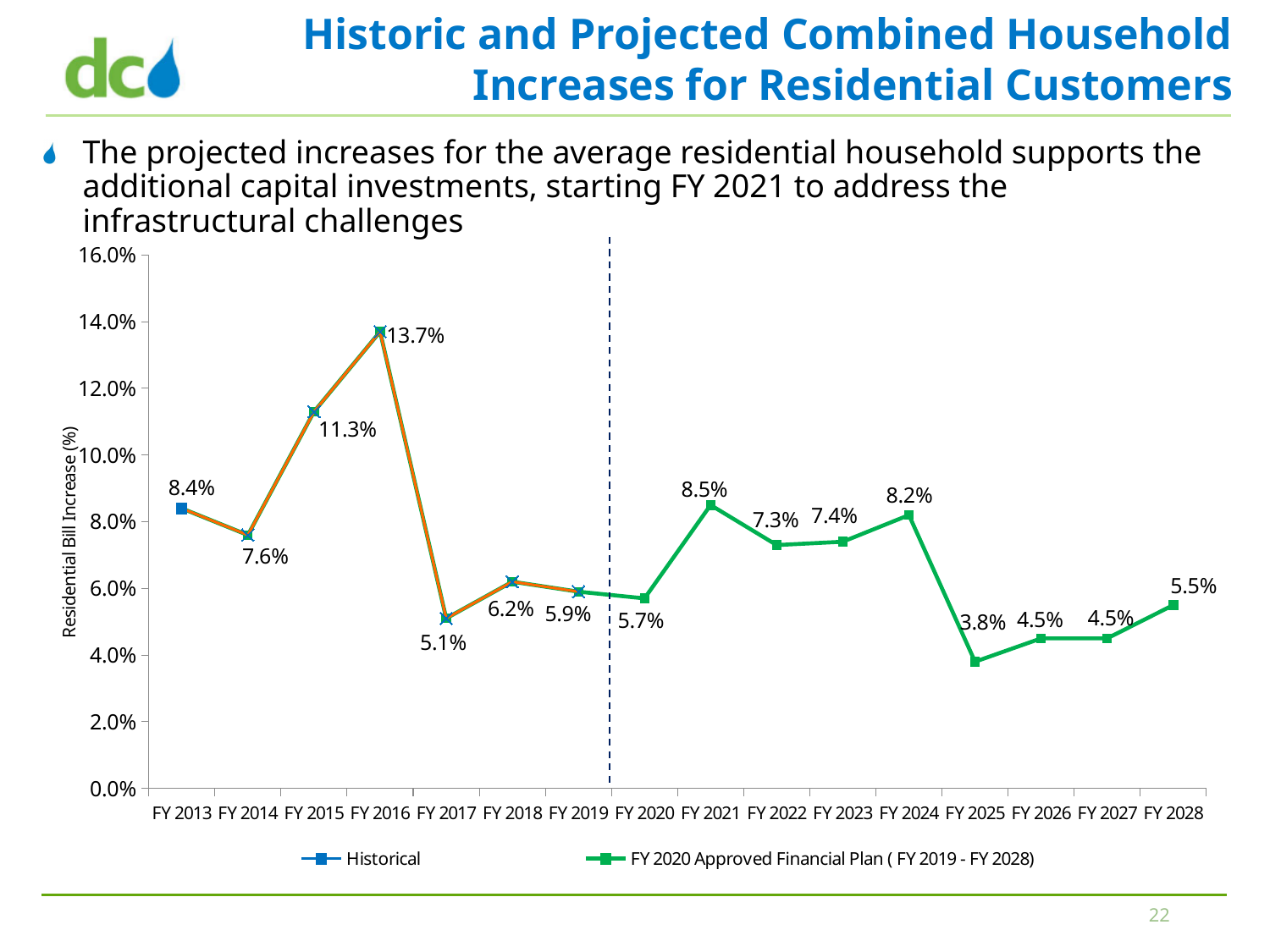
Is the residential bill increase for FY 2028 greater or less than 6.0%? less How many series does the legend list? 2 What is the difference between the residential bill increase in FY 2016 and FY 2017? 8.6% How many fiscal years are shown on the x axis? 16 Which fiscal year has the lowest residential bill increase? FY 2025 What is the residential bill increase for FY 2021? 8.5% What is the residential bill increase for FY 2016? 13.7% Which is larger, the residential bill increase for FY 2015 or for FY 2024? FY 2015 What is the residential bill increase for FY 2025? 3.8% What kind of chart is shown on the slide? line chart Do the residential bill increases rise or fall from FY 2024 to FY 2025? fall Which fiscal year has the highest residential bill increase? FY 2016